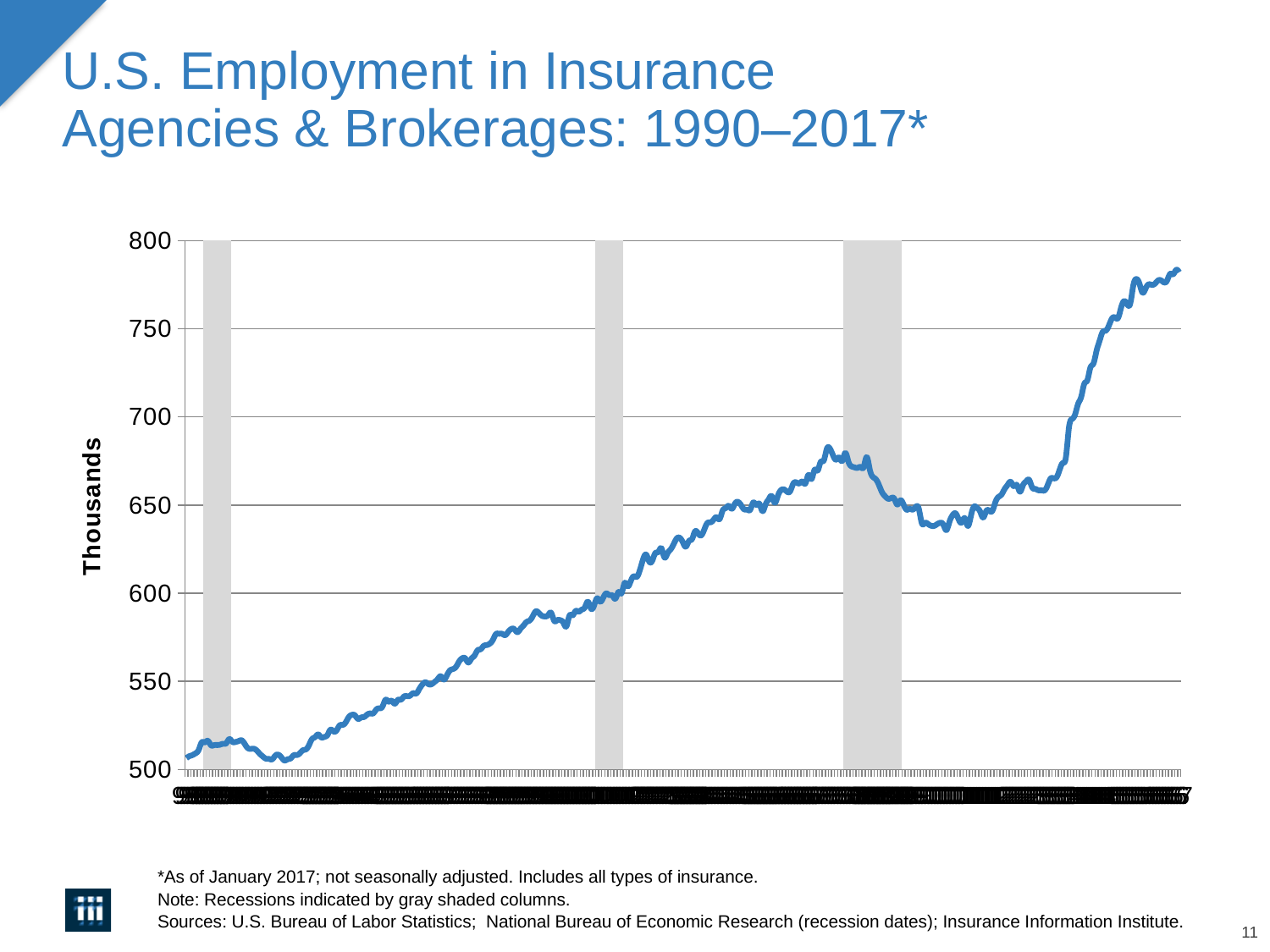
Is the lowest point of the line greater or less than 550? less Is the value at the end of the series (January 2017) greater or less than 750? greater Overall, do the values rise or fall from the start of the series to the end? rise Is the value at the start of the series (1990) greater or less than 550? less How many gray shaded recession columns are shown on the chart? 3 What kind of chart is shown on the slide? line chart What is the label on the vertical axis? Thousands Does the line rise or fall during the third (rightmost) gray recession band? fall